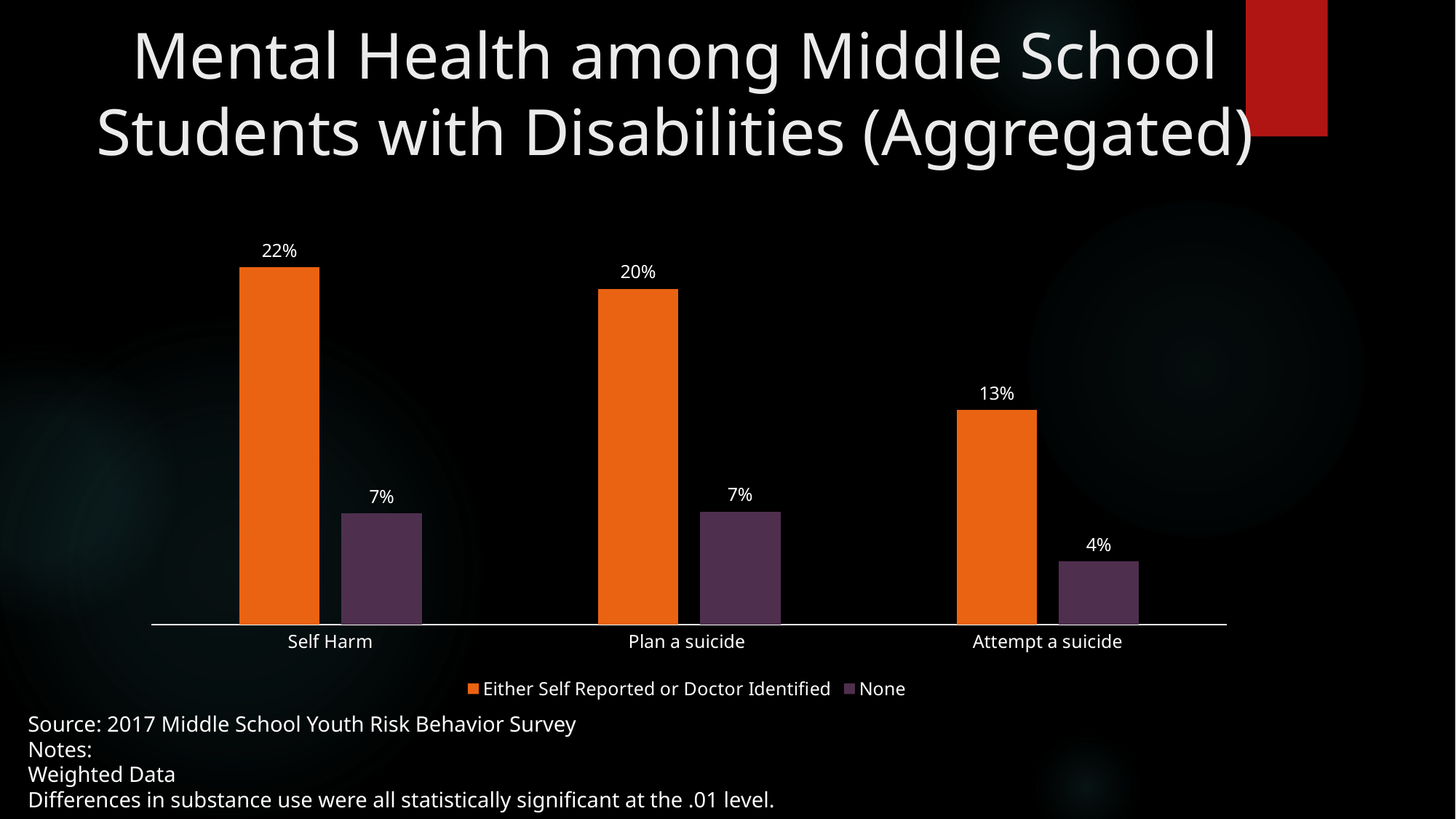
What is the difference between the 'Either Self Reported or Doctor Identified' and 'None' values for Self Harm? 15% What is the value for Self Harm in the 'Either Self Reported or Doctor Identified' series? 22% Which is larger for Attempt a suicide: the 'Either Self Reported or Doctor Identified' value or the 'None' value? Either Self Reported or Doctor Identified How many categories are shown on the x axis? 3 Which category has the highest value in the 'Either Self Reported or Doctor Identified' series? Self Harm What is the value for Attempt a suicide in the 'None' series? 4% Do the values in the 'Either Self Reported or Doctor Identified' series rise or fall from left to right across the categories? Fall What is the value for Plan a suicide in the 'Either Self Reported or Doctor Identified' series? 20% Which category has the lowest value in the 'None' series? Attempt a suicide How many series does the legend list? 2 What kind of chart is shown on the slide? Bar chart What is the difference between the 'Either Self Reported or Doctor Identified' values for Plan a suicide and Attempt a suicide? 7%